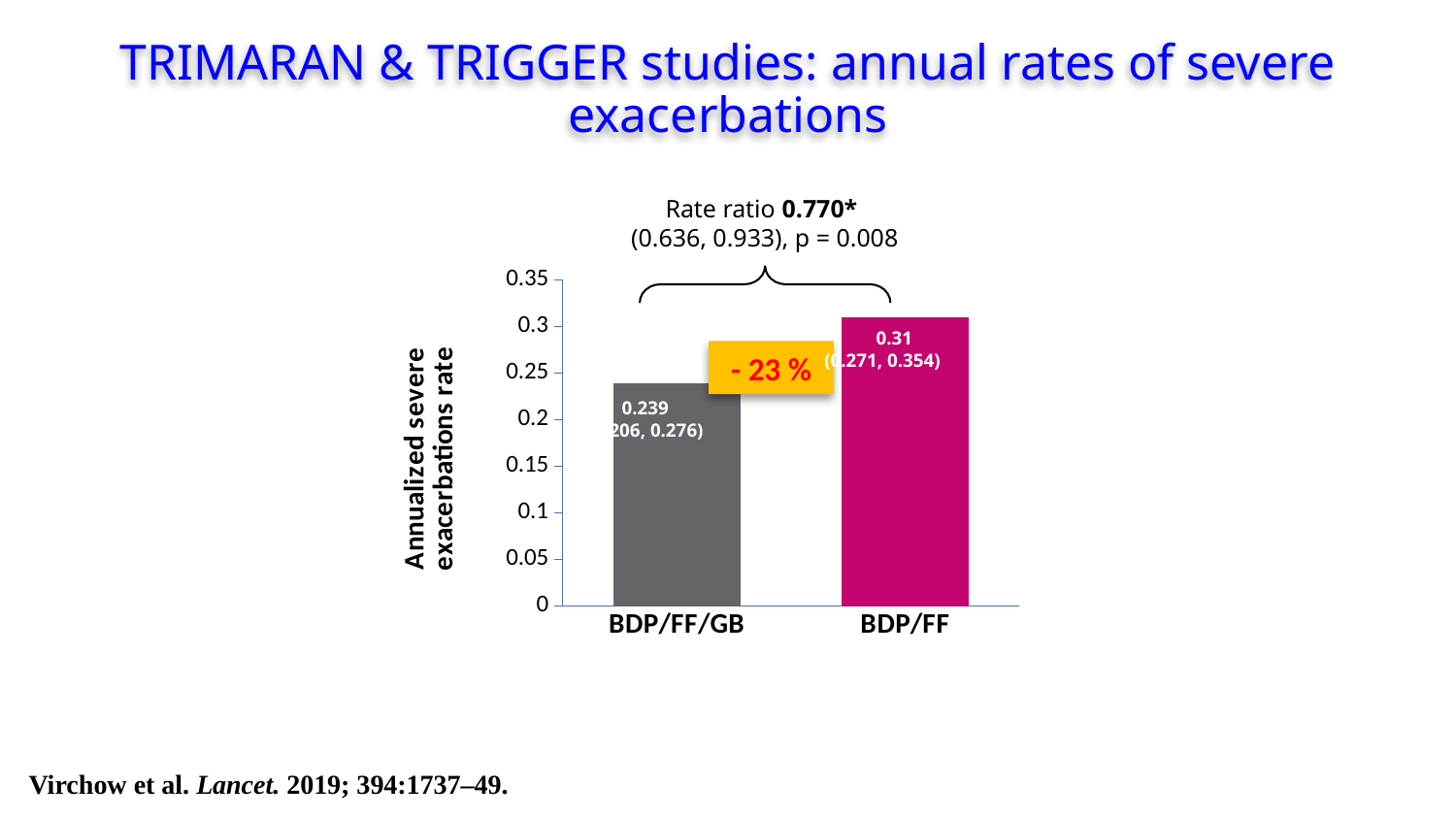
Is the annualized severe exacerbations rate for BDP/FF greater or less than 0.3? greater What is the annualized severe exacerbations rate for BDP/FF/GB? 0.239 Which treatment group has the higher annualized severe exacerbations rate? BDP/FF What type of chart is shown on the slide? Bar chart What percentage reduction is shown in the orange box between the bars? - 23 % What is the annualized severe exacerbations rate for BDP/FF? 0.31 Which treatment group has the lower annualized severe exacerbations rate? BDP/FF/GB What is the p-value shown for the rate ratio? p = 0.008 What is the difference between the annualized severe exacerbations rates of BDP/FF and BDP/FF/GB? 0.071 Is the annualized severe exacerbations rate for BDP/FF/GB greater or less than 0.25? less How many treatment groups are shown in the chart? 2 What is the rate ratio shown above the chart? 0.770*